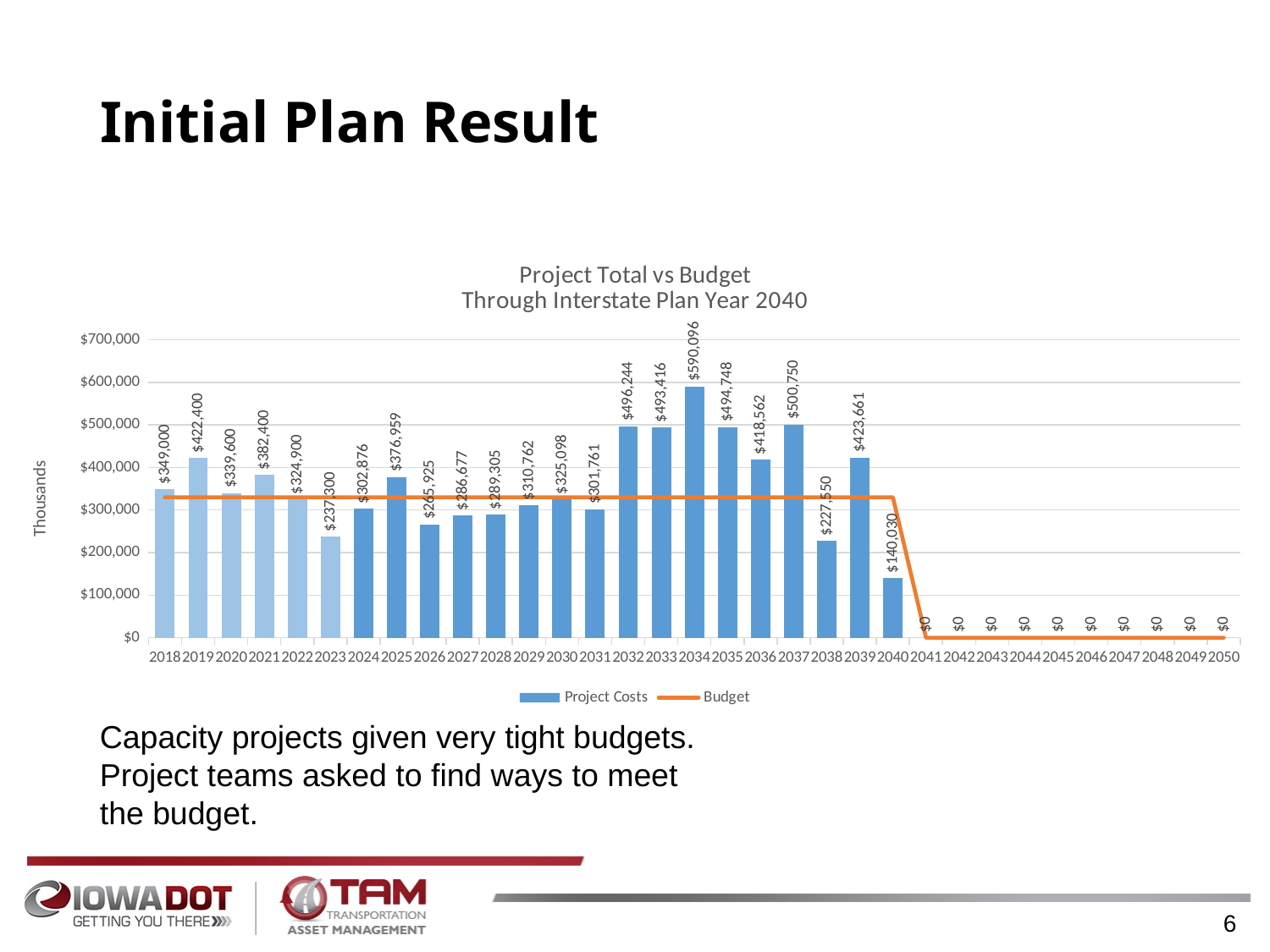
Which year has the larger Project Costs value, 2032 or 2036? 2032 What is the Project Costs value for 2034? $590,096 Is the Budget line value for 2030 greater or less than $300,000? greater Which year has the highest Project Costs value? 2034 What is the Project Costs value for 2040? $140,030 What is the difference between the Project Costs values for 2019 and 2018? $73,400 What is the Project Costs value for 2023? $237,300 What is the difference between the Project Costs values for 2034 and 2037? $89,346 How many years are shown on the x axis of the chart? 33 How many series does the chart legend list? 2 What is the title of the chart? Project Total vs Budget Through Interstate Plan Year 2040 Which year from 2018 to 2040 has the lowest Project Costs value? 2040